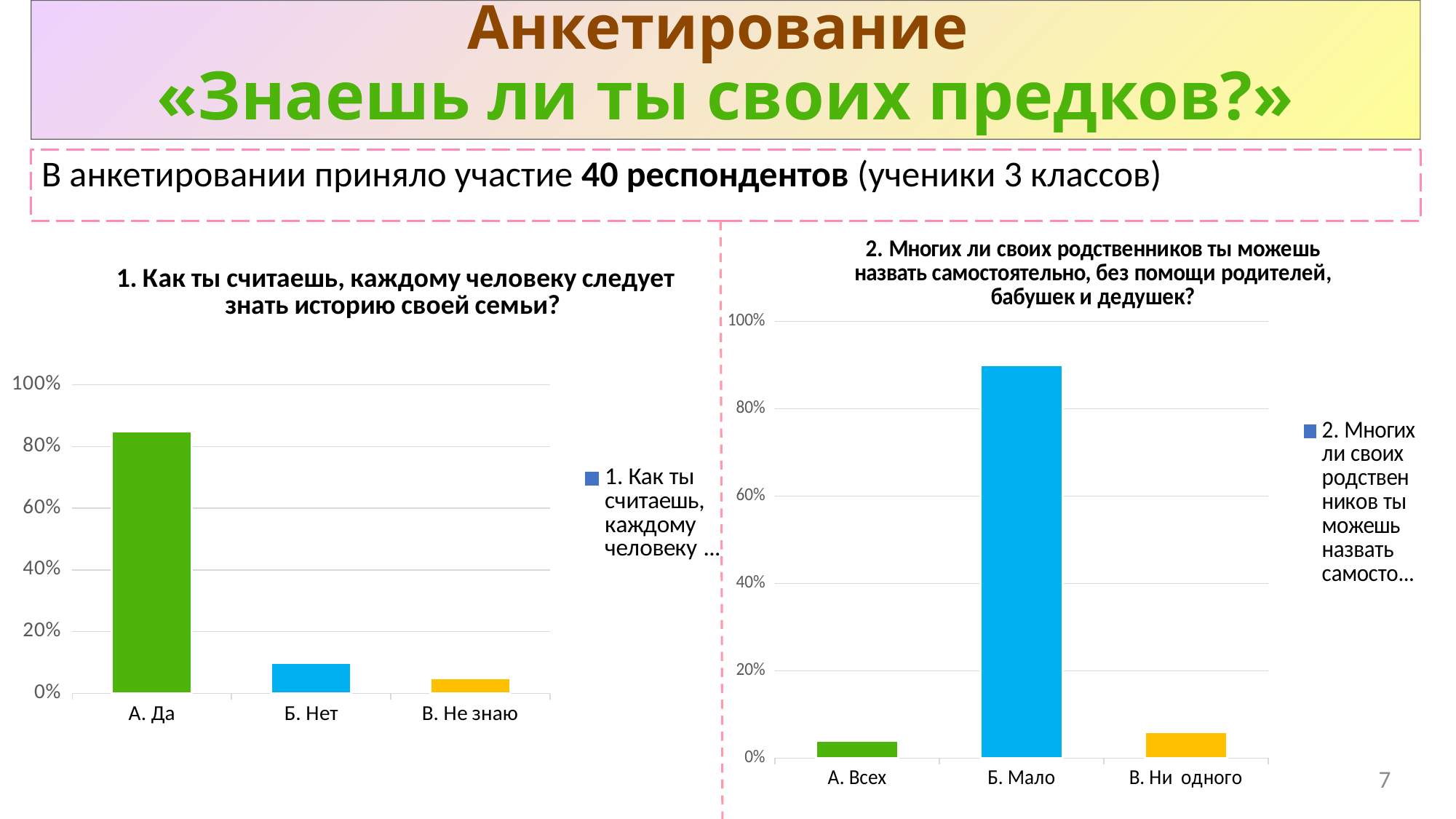
On the right chart (question 2), which category has the lowest value? А. Всех On the left chart (question 1), is the value for А. Да greater or less than 80%? greater On the right chart (question 2), which category has the highest value? Б. Мало On the right chart (question 2), is the value for Б. Мало greater or less than 80%? greater On the left chart (question 1), which category has the lowest value? В. Не знаю On the right chart (question 2), which is larger: the value for А. Всех or the value for Б. Мало? Б. Мало On the left chart (question 1), is the value for Б. Нет greater or less than 20%? less On the left chart (question 1), how many categories are shown on the x axis? 3 On the left chart (question 1), what colour is the bar for А. Да? green On the left chart (question 1), which category has the highest value? А. Да What type of chart is the right chart (question 2)? bar chart